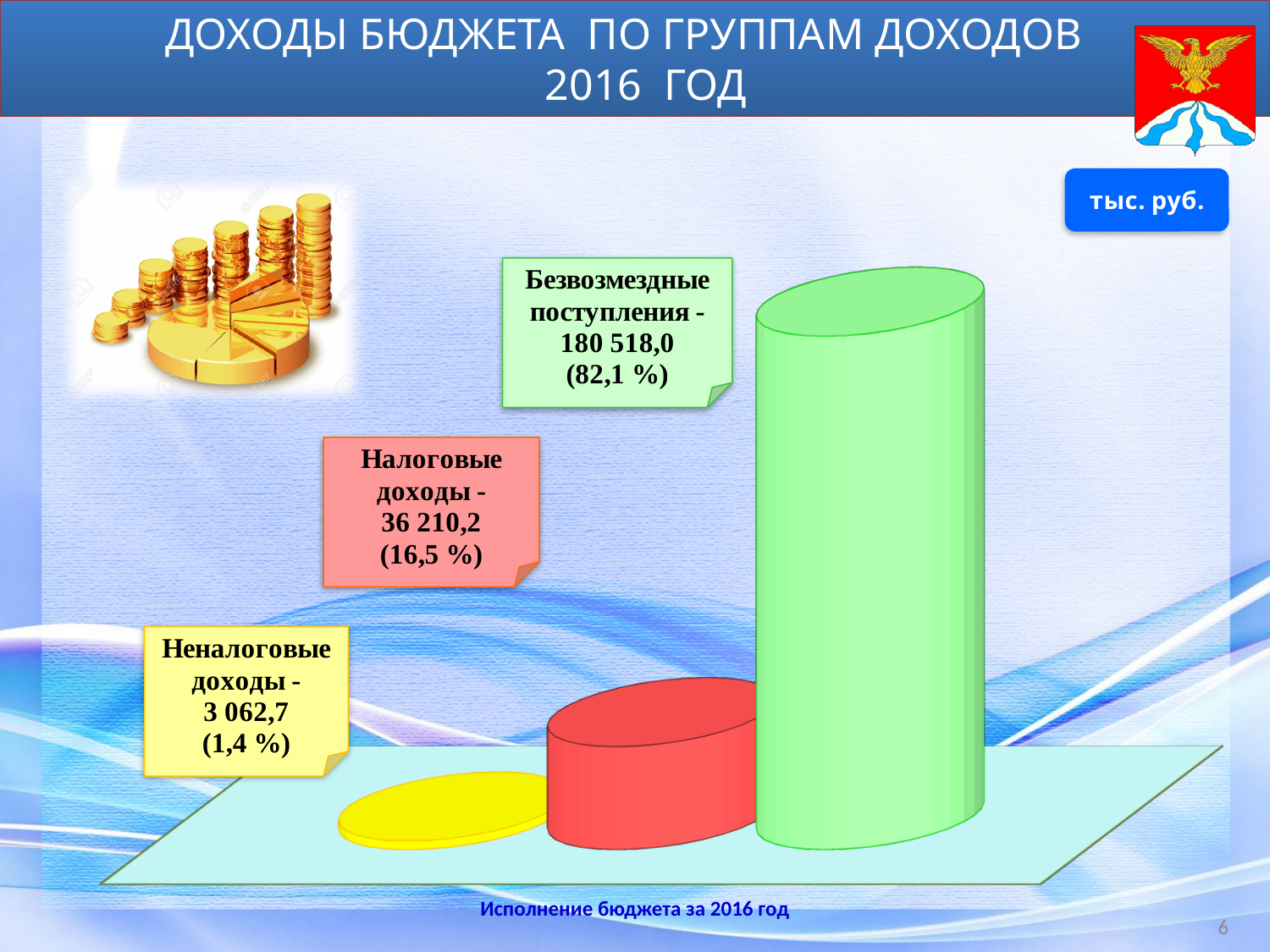
What is the value for Неналоговые доходы? 3 062,7 What is the value for Налоговые доходы? 36 210,2 What share of total income do Безвозмездные поступления make up? 82,1 % How many income groups are shown in the chart? 3 What is the value for Безвозмездные поступления? 180 518,0 Which income group has the lowest value? Неналоговые доходы Which income group has the highest value? Безвозмездные поступления What is the difference between Безвозмездные поступления and Налоговые доходы? 144 307,8 What is the difference between Налоговые доходы and Неналоговые доходы? 33 147,5 Which is larger, Налоговые доходы or Неналоговые доходы? Налоговые доходы What kind of chart is shown on the slide? bar chart In what units are the chart values given? тыс. руб.